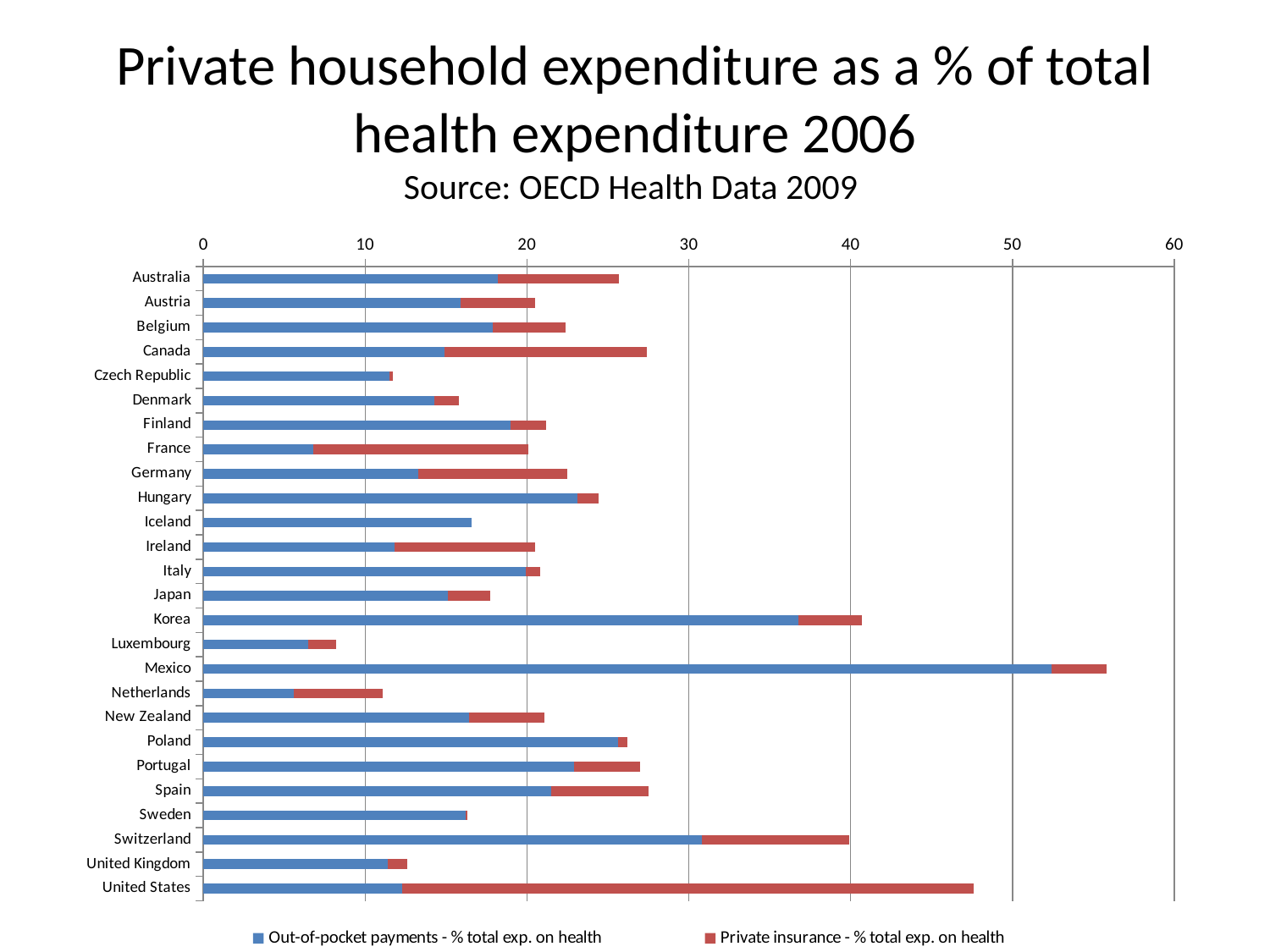
What kind of chart is shown on the slide? Stacked bar chart Is the out-of-pocket payments value for Mexico greater or less than 50? greater What data source is cited in the chart title? OECD Health Data 2009 Which country has the shortest total bar (lowest private household expenditure)? Luxembourg How many countries are listed on the chart? 26 Which country has the longest total bar (highest private household expenditure)? Mexico Is the out-of-pocket payments value for France greater or less than 10? less Is the total bar for the United States greater or less than 40? greater Which has a larger out-of-pocket payments segment, Hungary or Germany? Hungary Which has a longer total bar, Switzerland or Spain? Switzerland Which country has the largest private insurance segment? United States How many series does the legend list? 2